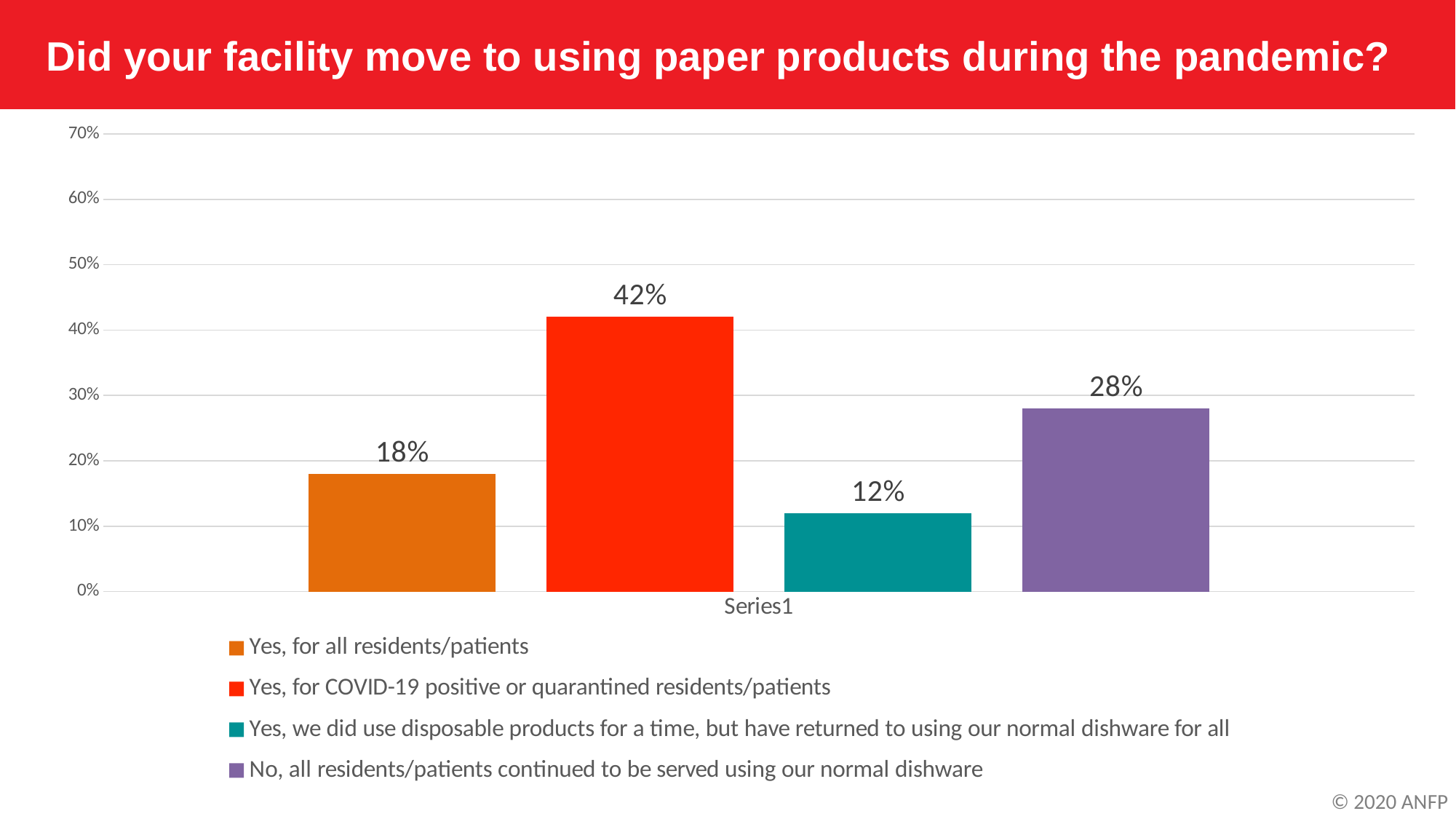
What percentage of respondents said yes, for COVID-19 positive or quarantined residents/patients? 42% Which response has the highest percentage? Yes, for COVID-19 positive or quarantined residents/patients What percentage of respondents said yes, for all residents/patients? 18% What percentage said they used disposable products for a time but have returned to normal dishware for all? 12% What is the difference between the percentage for 'Yes, for COVID-19 positive or quarantined residents/patients' and 'No, all residents/patients continued to be served using our normal dishware'? 14% What type of chart is shown on the slide? Bar chart What colour is the bar for 'Yes, for COVID-19 positive or quarantined residents/patients'? Red What is the title of the slide? Did your facility move to using paper products during the pandemic? Which is larger: the percentage for 'Yes, for all residents/patients' or for 'No, all residents/patients continued to be served using our normal dishware'? No, all residents/patients continued to be served using our normal dishware What percentage said no, all residents/patients continued to be served using normal dishware? 28% Which response has the lowest percentage? Yes, we did use disposable products for a time, but have returned to using our normal dishware for all How many response categories are shown in the chart? 4